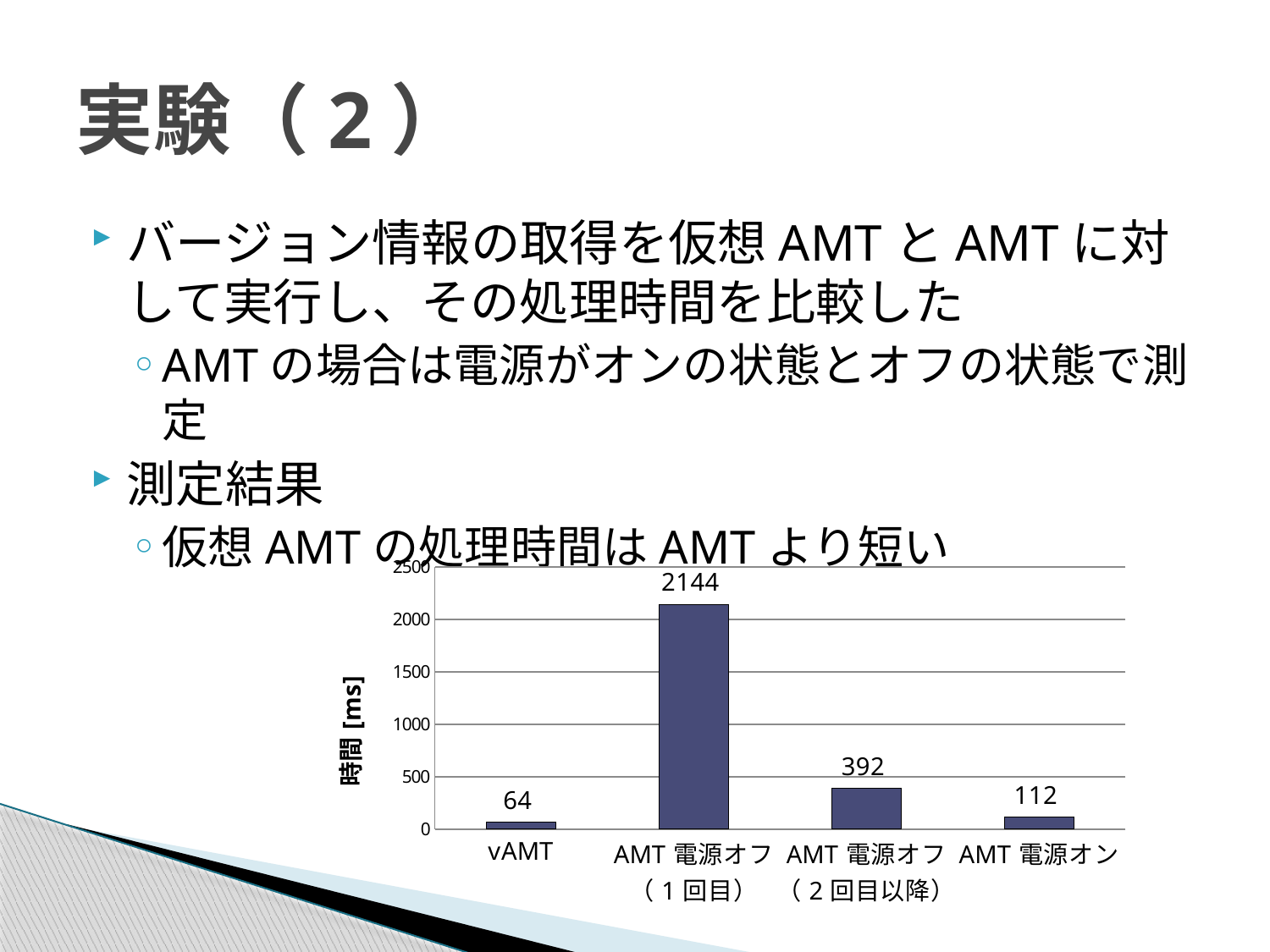
What is the value for AMT 電源オフ（1回目）? 2144 Which category has the lowest value? vAMT How many categories are shown on the x axis? 4 What is the difference between the values for AMT 電源オフ（1回目） and AMT 電源オフ（2回目以降）? 1752 Which is larger, the value for AMT 電源オン or the value for AMT 電源オフ（2回目以降）? AMT 電源オフ（2回目以降） Which category has the highest value? AMT 電源オフ（1回目） What is the value for vAMT? 64 What is the difference between the values for AMT 電源オン and vAMT? 48 What kind of chart is shown on the slide? bar chart What is the label of the y axis? 時間 [ms] What is the value for AMT 電源オン? 112 What is the value for AMT 電源オフ（2回目以降）? 392